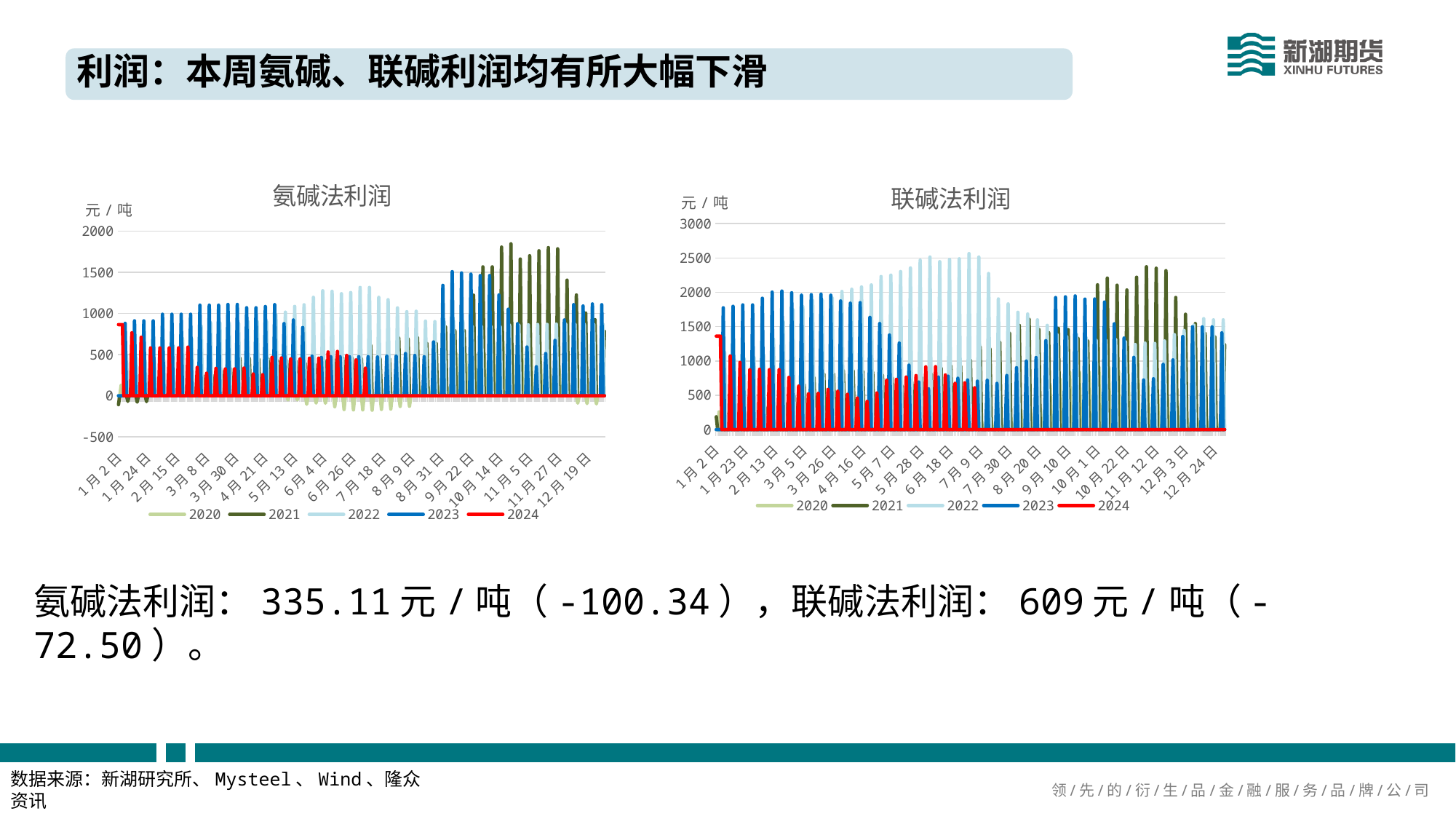
In the 联碱法利润 chart, is the peak value of the 2021 series greater or less than 2000? greater In the 氨碱法利润 chart, is the peak value of the 2021 series greater or less than 1500? greater In the 氨碱法利润 chart, which series reaches the highest value? 2021 Which years are listed in the legend of the 氨碱法利润 chart? 2020, 2021, 2022, 2023, 2024 How many series does the legend of the 联碱法利润 chart list? 5 In the 氨碱法利润 chart, are the 2024 values in March greater or less than 500? less What unit is shown on the y axis of the 联碱法利润 chart? 元/吨 What is the highest tick shown on the y axis of the 联碱法利润 chart? 3000 What kind of chart is the 氨碱法利润 chart on the left? bar chart